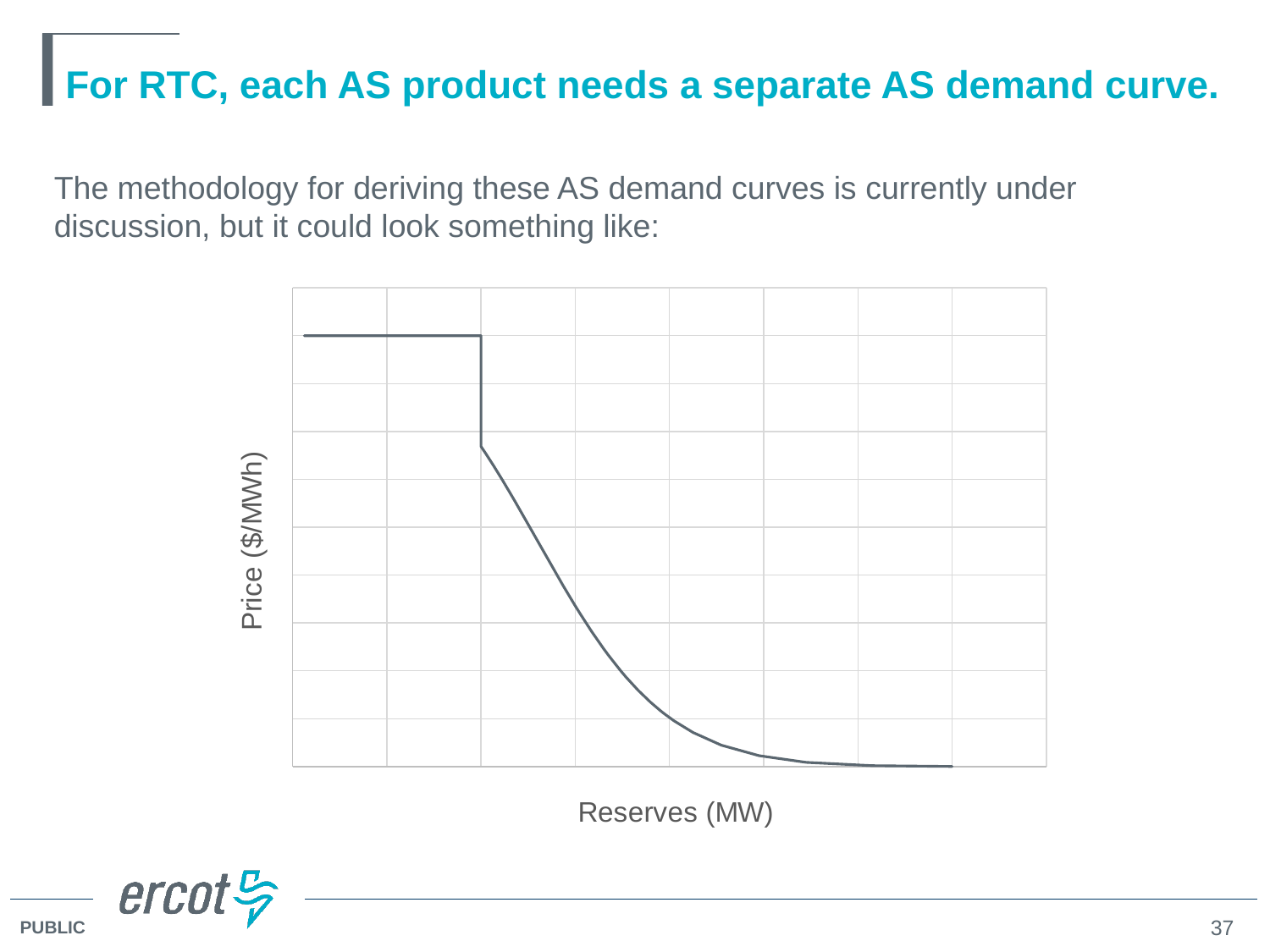
How many lines are plotted on the chart? 1 What is the label of the horizontal axis of the chart? Reserves (MW) Is the plotted price higher at the left end of the curve or at the right end? left end Do the plotted values rise or fall as reserves increase along the x axis? fall What is the label of the vertical axis of the chart? Price ($/MWh) What kind of chart is shown on the slide? line chart